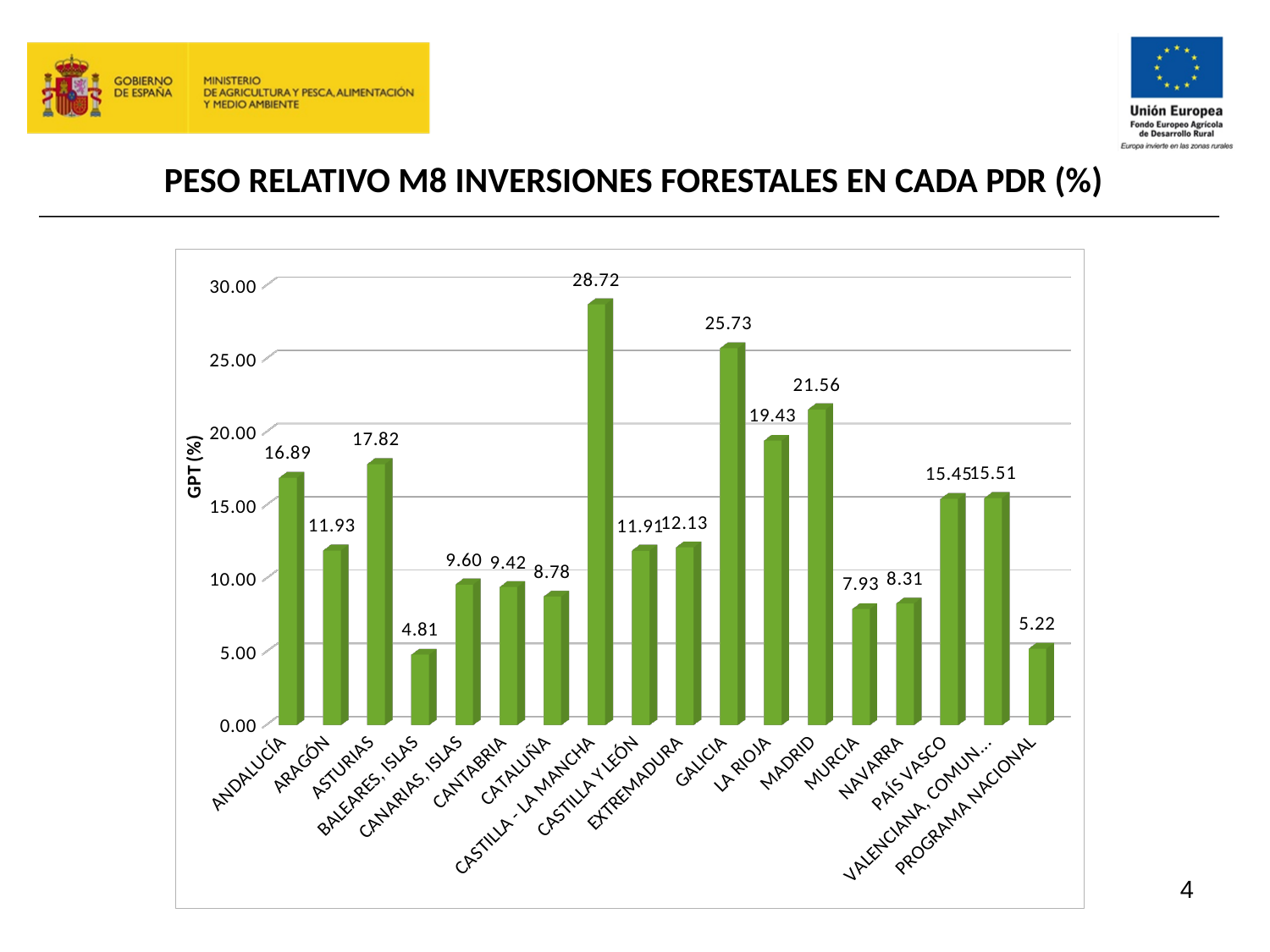
Which category has the highest value? CASTILLA - LA MANCHA Which category has the lowest value? BALEARES, ISLAS What is the value for MADRID? 21.56 Which is larger, the value for LA RIOJA or the value for MADRID? MADRID What is the difference between the values for CASTILLA - LA MANCHA and GALICIA? 2.99 What is the difference between the values for ASTURIAS and ANDALUCÍA? 0.93 What is the label of the y axis? GPT (%) What is the value for BALEARES, ISLAS? 4.81 What kind of chart is shown on the slide? Bar chart What is the value for GALICIA? 25.73 Is the value for PROGRAMA NACIONAL greater or less than 10.00? less How many categories are shown on the x axis? 18